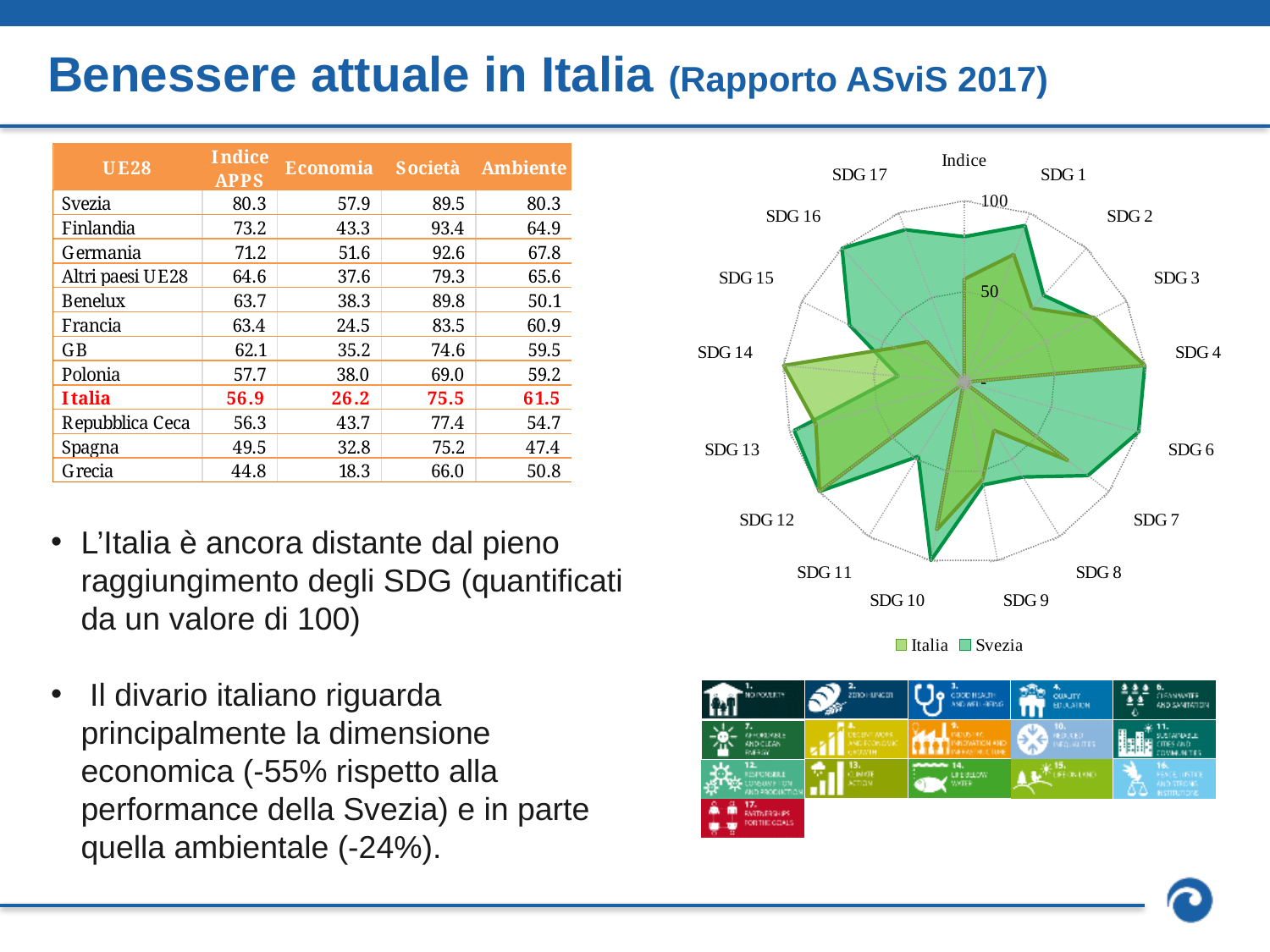
In the radar chart, which series has the larger value at SDG 14, Italia or Svezia? Italia Which two series are listed in the legend of the radar chart? Italia and Svezia In the radar chart, is the value for Italia at SDG 10 greater or less than 50? greater In the radar chart, is the value for Italia at SDG 13 greater or less than 50? greater What kind of chart is shown on the right side of the slide? radar chart How many series does the legend of the radar chart list? 2 How many categories (axes) does the radar chart have? 17 In the radar chart, which series has the larger value at SDG 16, Italia or Svezia? Svezia In the radar chart, is the value for Svezia at SDG 4 greater or less than 50? greater What is the highest value shown on the radar chart's axis scale? 100